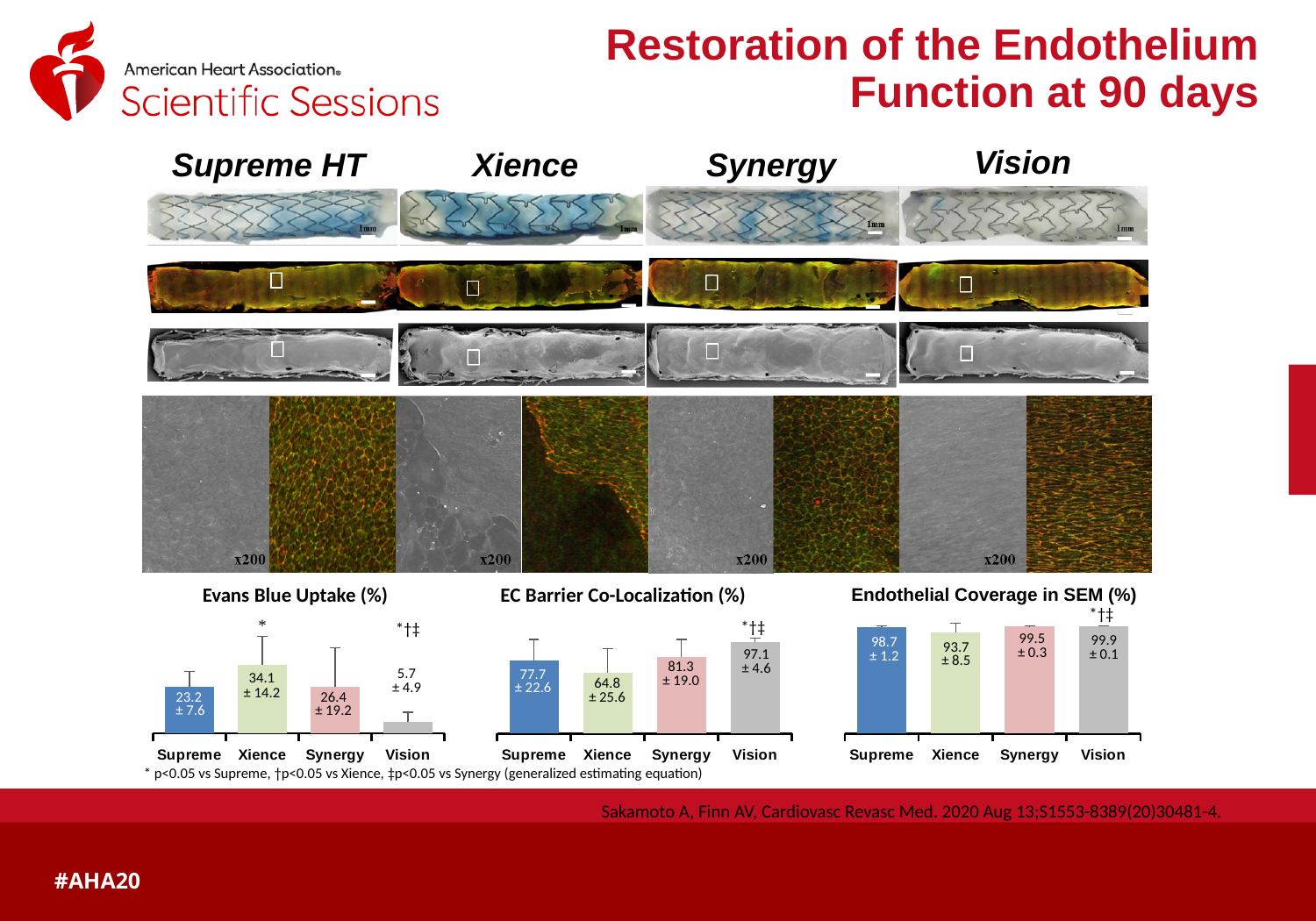
In the Evans Blue Uptake (%) chart, which stent has the lowest value? Vision In the Evans Blue Uptake (%) chart, what is the value for Xience? 34.1 ± 14.2 In the EC Barrier Co-Localization (%) chart, what is the mean value for Vision? 97.1 In the EC Barrier Co-Localization (%) chart, which stent has the lowest value? Xience In the Endothelial Coverage in SEM (%) chart, which stent has the lowest value? Xience How many stent categories are shown in the Evans Blue Uptake (%) chart? 4 In the Evans Blue Uptake (%) chart, which stent has the highest value? Xience In the Endothelial Coverage in SEM (%) chart, which is larger, the mean value for Supreme or for Xience? Supreme In the Endothelial Coverage in SEM (%) chart, what is the value for Synergy? 99.5 ± 0.3 In the Evans Blue Uptake (%) chart, what is the difference between the mean values for Supreme and Vision? 17.5 What type of chart is the EC Barrier Co-Localization (%) chart? Bar chart In the EC Barrier Co-Localization (%) chart, what is the difference between the mean values for Vision and Supreme? 19.4